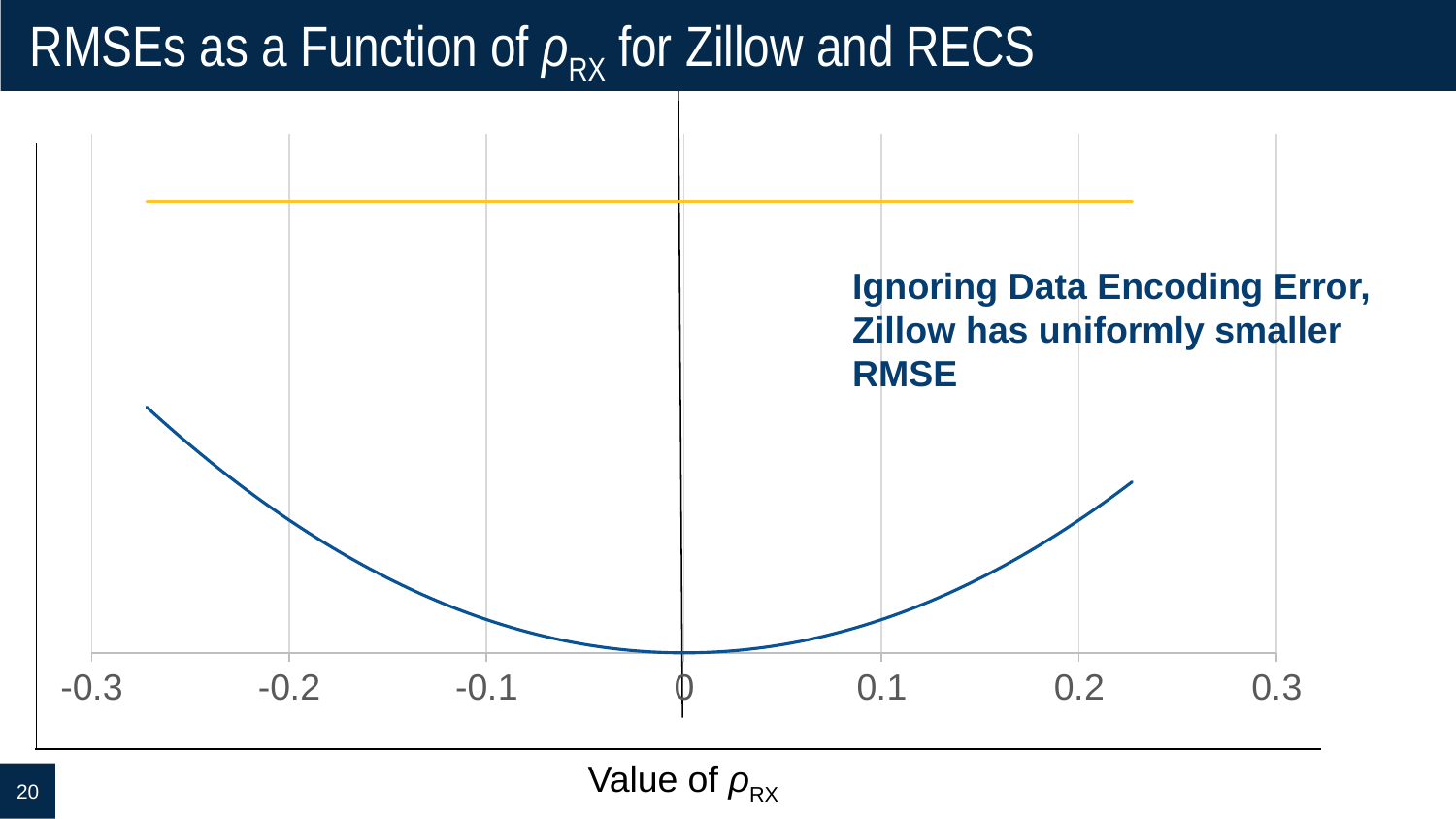
How many lines are plotted on the chart? 2 What kind of chart is shown on the slide? line chart Which line stays flat across the x axis, the yellow line or the blue curve? the yellow line Which line is higher across the whole x range, the yellow line or the blue curve? the yellow line How many tick labels are shown on the x axis? 7 Does the blue curve rise or fall as the x value goes from -0.3 to 0? fall What is the highest value labelled on the x axis? 0.3 What is the lowest value labelled on the x axis? -0.3 What is the title of the chart? RMSEs as a Function of ρRX for Zillow and RECS At which x-axis value does the blue curve reach its lowest point? 0 What is the label of the x axis? Value of ρRX Does the blue curve rise or fall as the x value goes from 0 to 0.2? rise